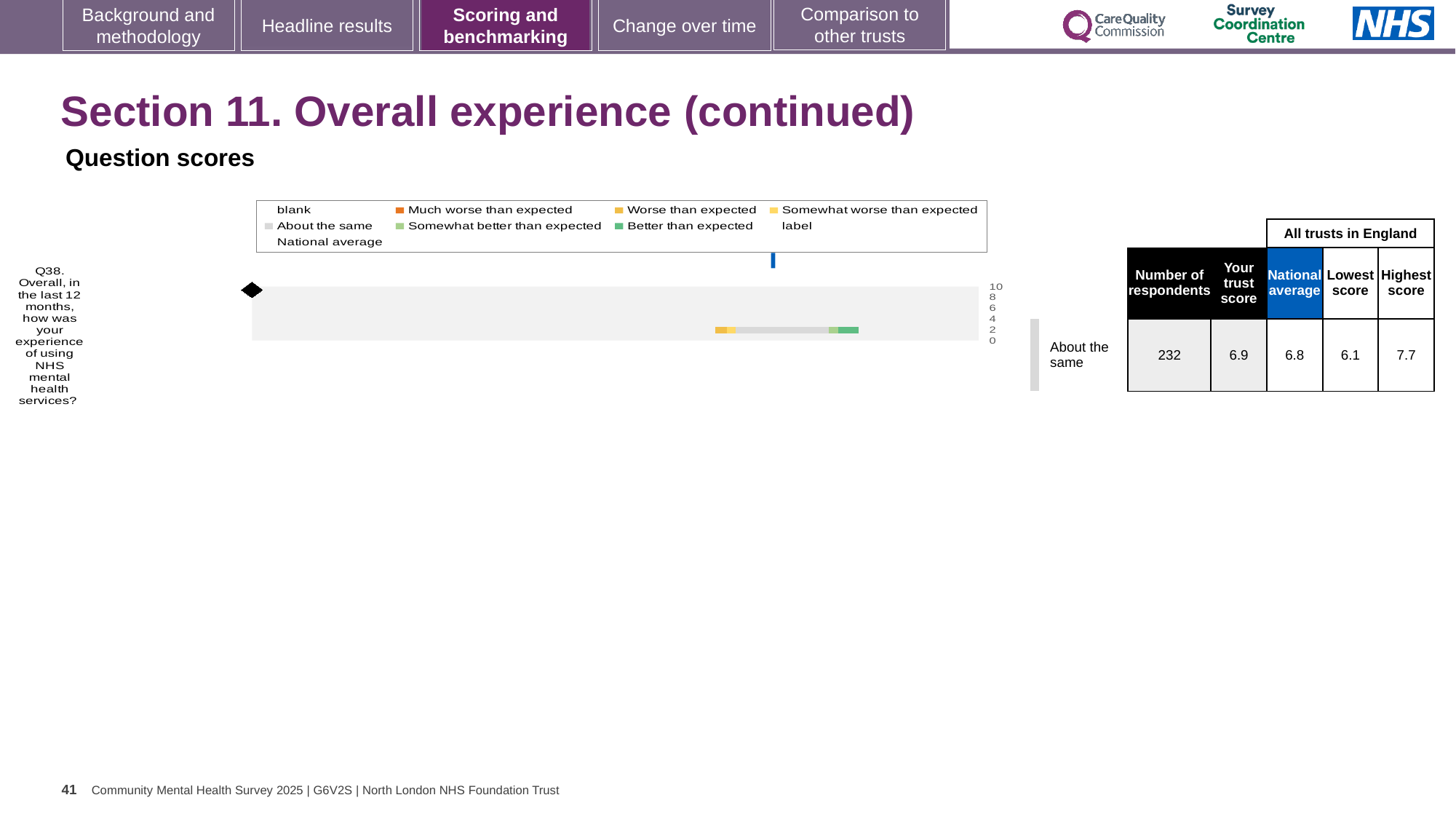
How many questions (categories) are plotted in the chart? 1 In the table beside the chart, what is the highest score among all trusts in England for Q38? 7.7 In the table beside the chart, what is the trust's score for Q38? 6.9 In the table beside the chart, what is the lowest score among all trusts in England for Q38? 6.1 What is the difference between the highest score and the lowest score for Q38 in the table? 1.6 In the table beside the chart, what is the number of respondents for Q38? 232 What is the highest value shown on the chart's axis? 10 Which question is plotted in the chart? Q38. Overall, in the last 12 months, how was your experience of using NHS mental health services? In the table beside the chart, what is the national average for Q38? 6.8 Which is larger for Q38, the trust's score or the national average? the trust's score What is the benchmark category label shown next to the chart for Q38? About the same What kind of chart is shown on the slide? bar chart